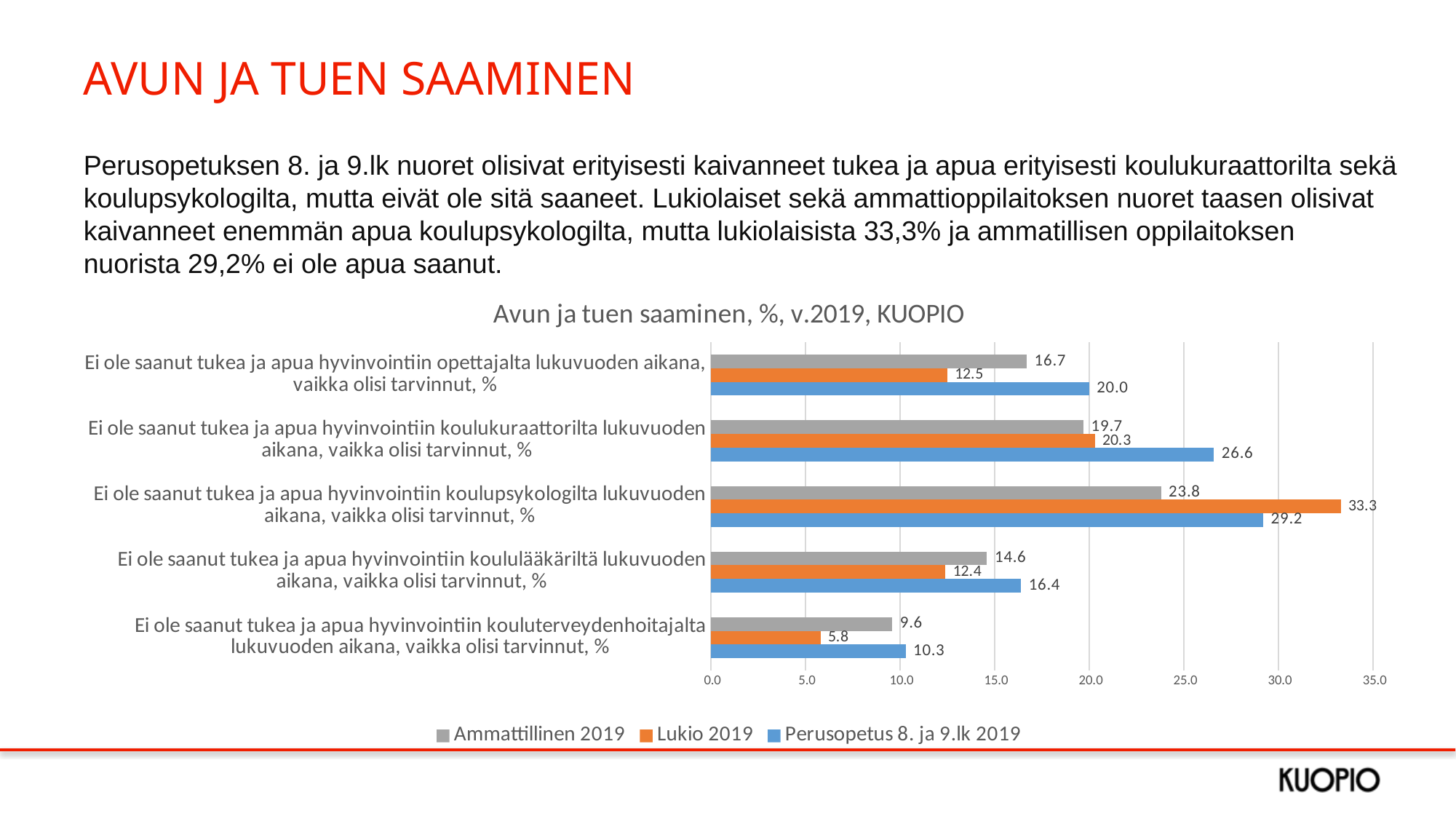
What is the title of the chart? Avun ja tuen saaminen, %, v.2019, KUOPIO How many categories are shown on the chart? 5 Is the value for Perusopetus 8. ja 9.lk 2019 in the opettaja (teacher) category greater or less than 15.0? greater Which category has the lowest value for Lukio 2019? Ei ole saanut tukea ja apua hyvinvointiin kouluterveydenhoitajalta lukuvuoden aikana, vaikka olisi tarvinnut, % What is the difference between the Lukio 2019 and Ammattillinen 2019 values in the koulupsykologi category? 9.5 What is the value for Lukio 2019 in the category about koulupsykologi (school psychologist)? 33.3 What is the value for Perusopetus 8. ja 9.lk 2019 in the category about koulukuraattori (school counsellor)? 26.6 How many series does the legend list? 3 In the koululääkäri (school doctor) category, which series has the larger value: Ammattillinen 2019 or Lukio 2019? Ammattillinen 2019 What kind of chart is shown on the slide? Bar chart Which category has the highest value for Perusopetus 8. ja 9.lk 2019? Ei ole saanut tukea ja apua hyvinvointiin koulupsykologilta lukuvuoden aikana, vaikka olisi tarvinnut, % What is the value for Ammattillinen 2019 in the category about kouluterveydenhoitaja (school nurse)? 9.6